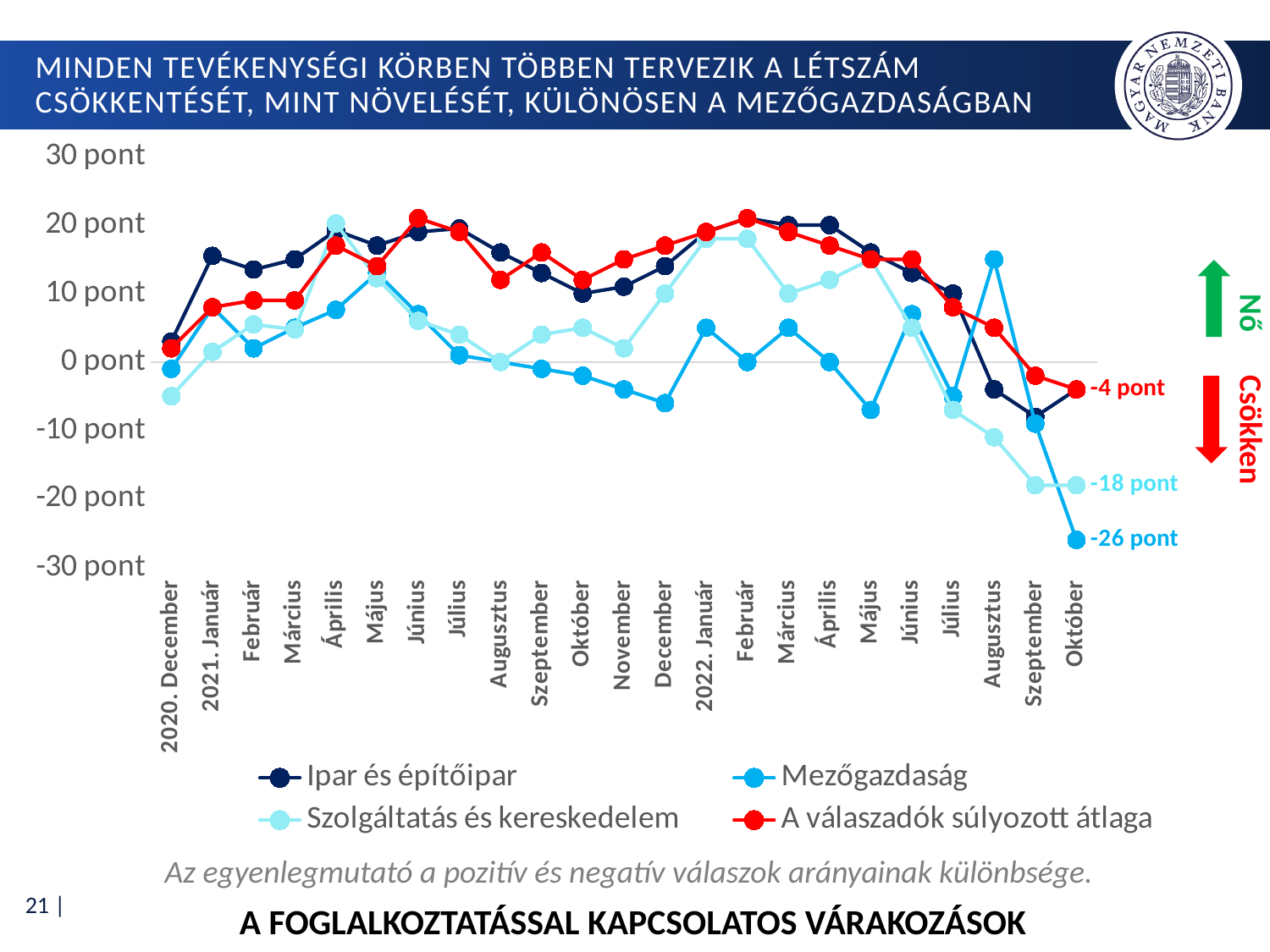
What is the value of Szolgáltatás és kereskedelem in Október 2022? -18 pont What is the value of A válaszadók súlyozott átlaga in Október 2022? -4 pont Which series has the lowest value in Október 2022? Mezőgazdaság What is the value of Mezőgazdaság in Október 2022? -26 pont What kind of chart is shown on the slide? line chart Is the value for Mezőgazdaság in Augusztus 2022 greater or less than 10 pont? greater What is the difference between the Október 2022 values of A válaszadók súlyozott átlaga and Mezőgazdaság? 22 pont How many months are shown on the x axis? 23 Does the Mezőgazdaság series rise or fall from Augusztus 2022 to Október 2022? fall Is the value for Szolgáltatás és kereskedelem in 2020. December greater or less than 0 pont? less In Október 2022, is the value for Szolgáltatás és kereskedelem higher or lower than the value for Mezőgazdaság? higher How many series does the legend list? 4